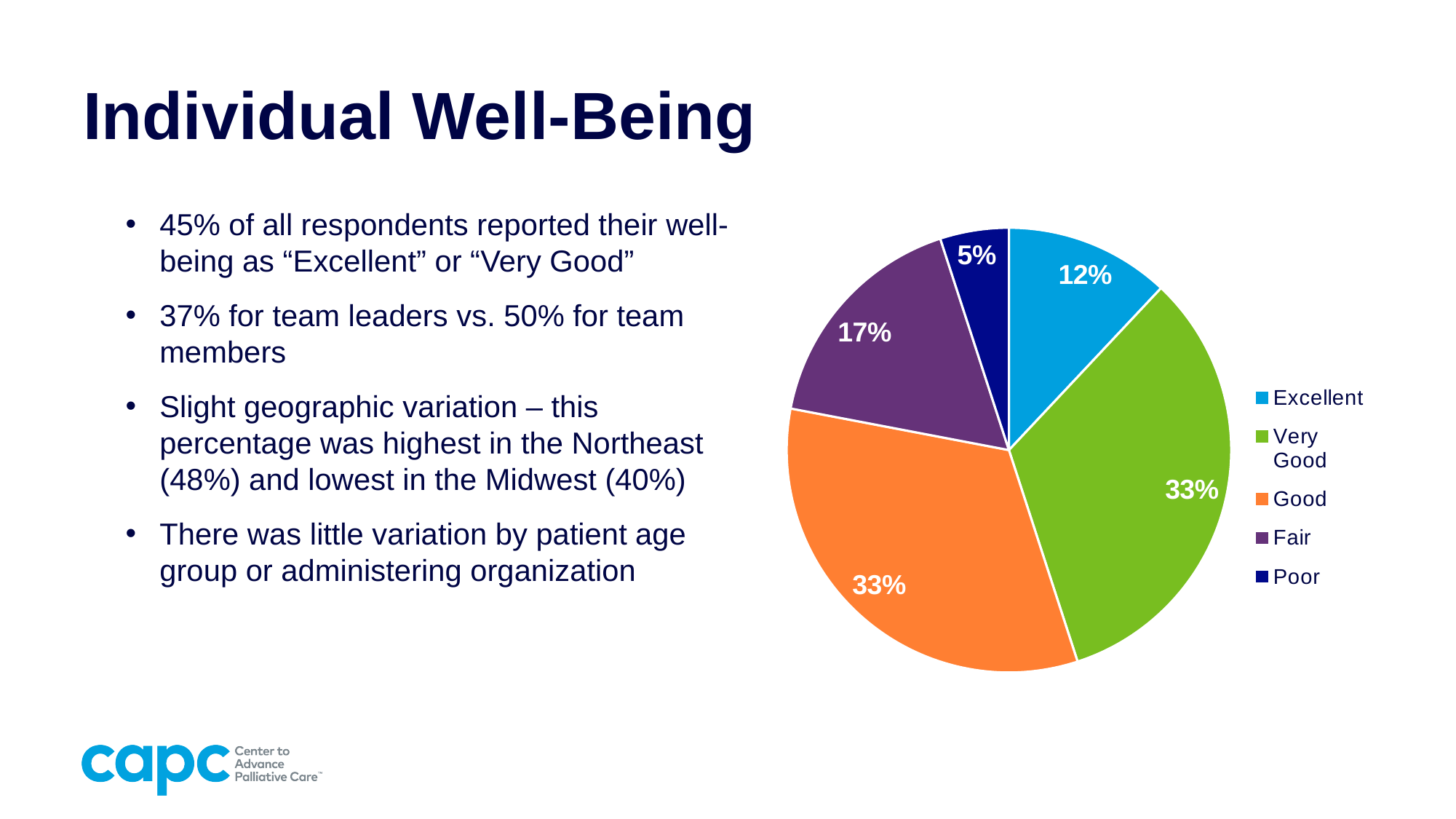
Which slice is larger, "Excellent" or "Fair"? Fair What type of chart is shown on the slide? Pie chart Which category has the smallest slice of the pie chart? Poor What share of the pie does the "Very Good" slice represent? 33% What percentage of respondents rated their well-being as "Good"? 33% What percentage of respondents rated their well-being as "Poor"? 5% What percentage of respondents rated their well-being as "Fair"? 17% What is the difference in percentage points between the "Fair" slice and the "Excellent" slice? 5% What percentage of respondents rated their well-being as "Excellent"? 12% What colour is the "Good" slice in the pie chart? Orange How many categories are shown in the pie chart? 5 What is the difference in percentage points between the "Very Good" slice and the "Poor" slice? 28%